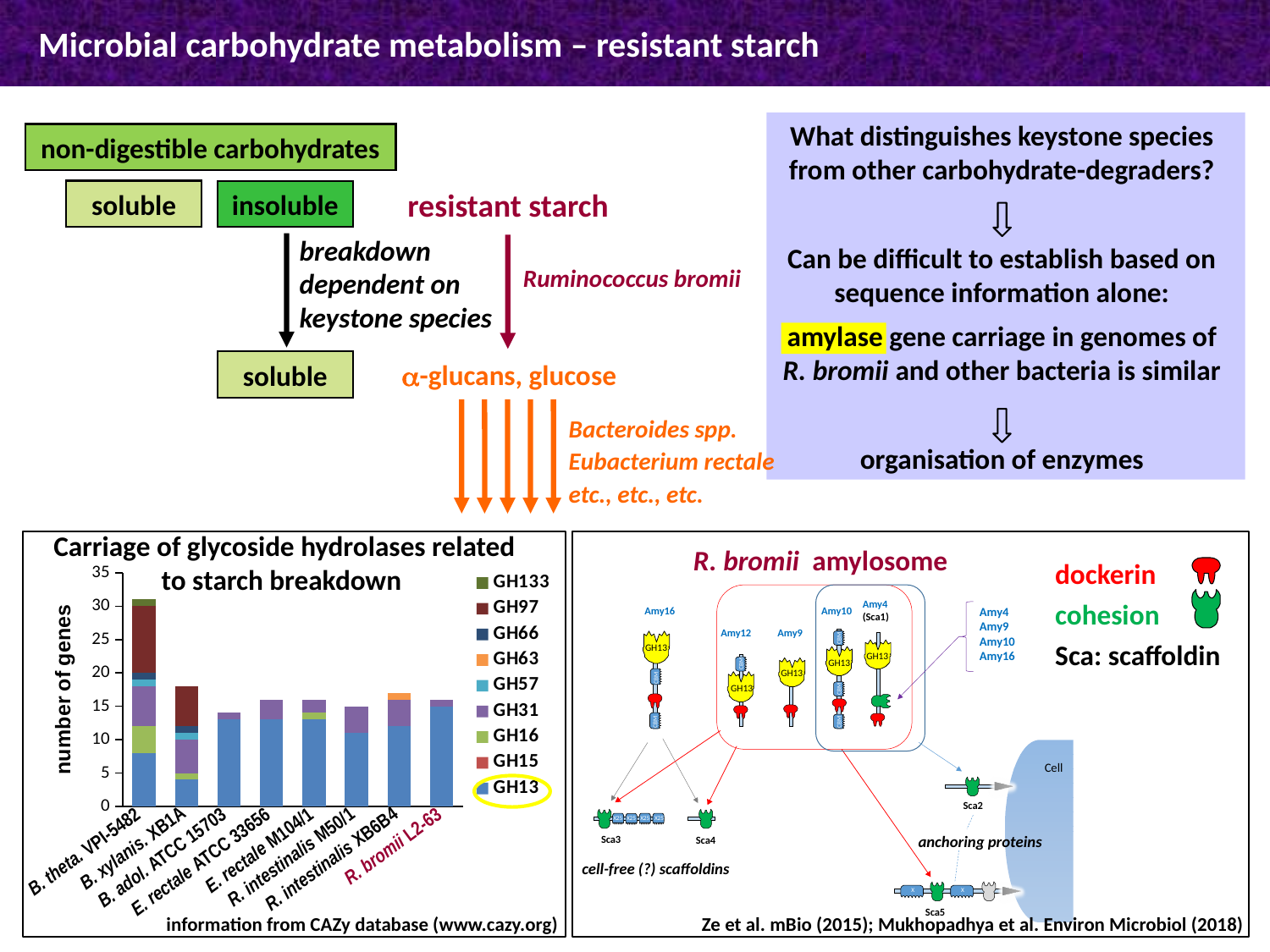
Is the total number of genes for B. xylanis. XB1A greater or less than 20? less What kind of chart is shown in the bottom-left panel of the slide? stacked bar chart How many GH families does the legend of the bar chart list? 9 Which has a larger total number of genes, B. theta. VPI-5482 or B. xylanis. XB1A? B. theta. VPI-5482 Is the total number of genes for R. bromii L2-63 greater or less than 10? greater How many bacterial strains (categories) are shown on the x axis of the bar chart? 8 What is the title of the bar chart on the slide? Carriage of glycoside hydrolases related to starch breakdown Is the total number of genes for B. adol. ATCC 15703 greater or less than 20? less Which legend entry in the bar chart is circled in yellow? GH13 Which strain has the highest total number of genes in the bar chart? B. theta. VPI-5482 Which strain has the larger GH13 segment, R. bromii L2-63 or B. theta. VPI-5482? R. bromii L2-63